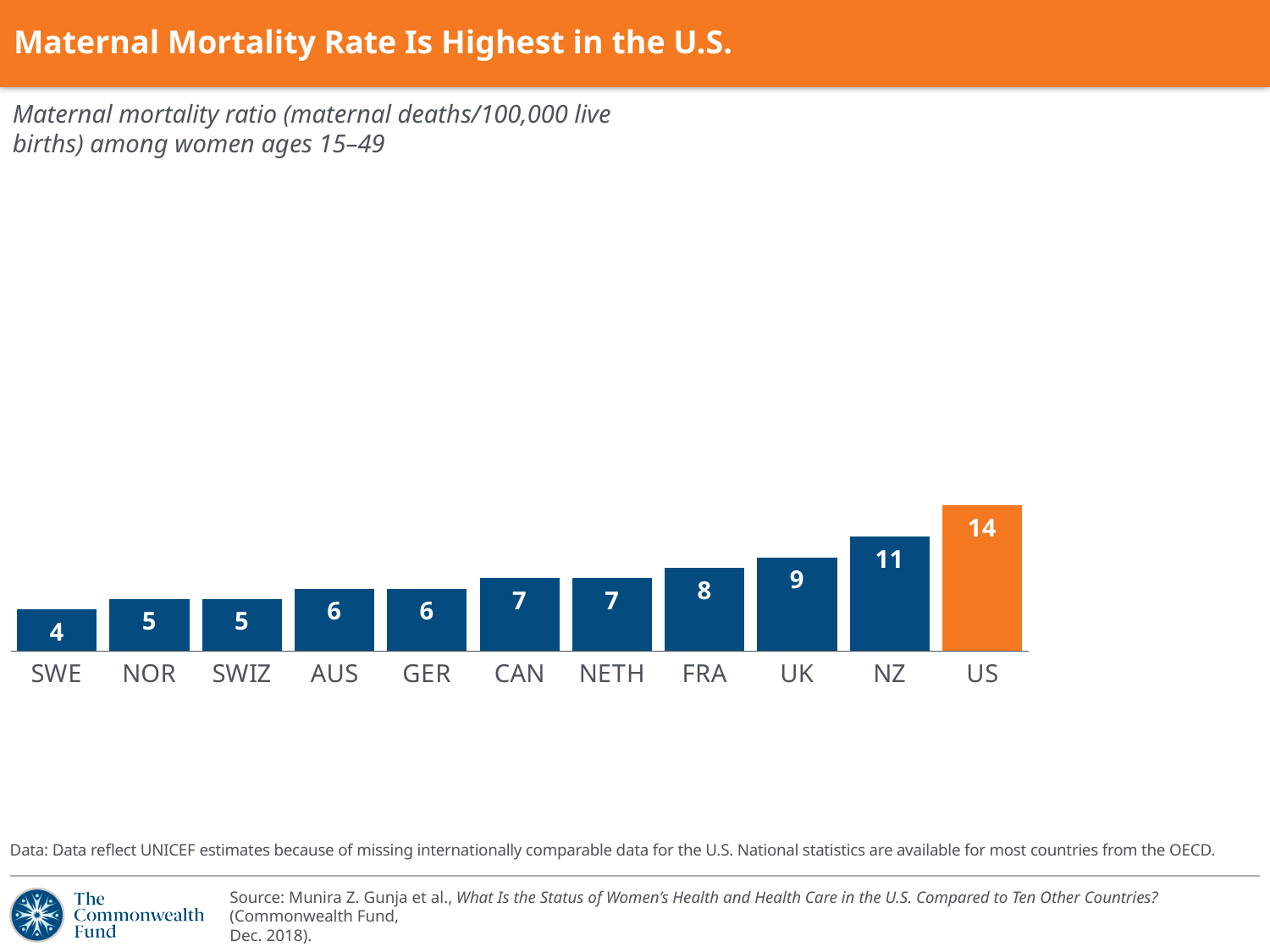
What is the difference between the maternal mortality ratio for the UK and for SWE? 5 Which has a higher maternal mortality ratio, UK or CAN? UK What is the maternal mortality ratio for SWE? 4 What is the maternal mortality ratio for the US? 14 What is the maternal mortality ratio for NZ? 11 Which country has the highest maternal mortality ratio? US Which country has the lowest maternal mortality ratio? SWE Do the values rise or fall from left to right across the chart? Rise What is the maternal mortality ratio for FRA? 8 What is the difference between the maternal mortality ratio for the US and for NZ? 3 How many countries are shown in the chart? 11 What kind of chart is shown on the slide? Bar chart